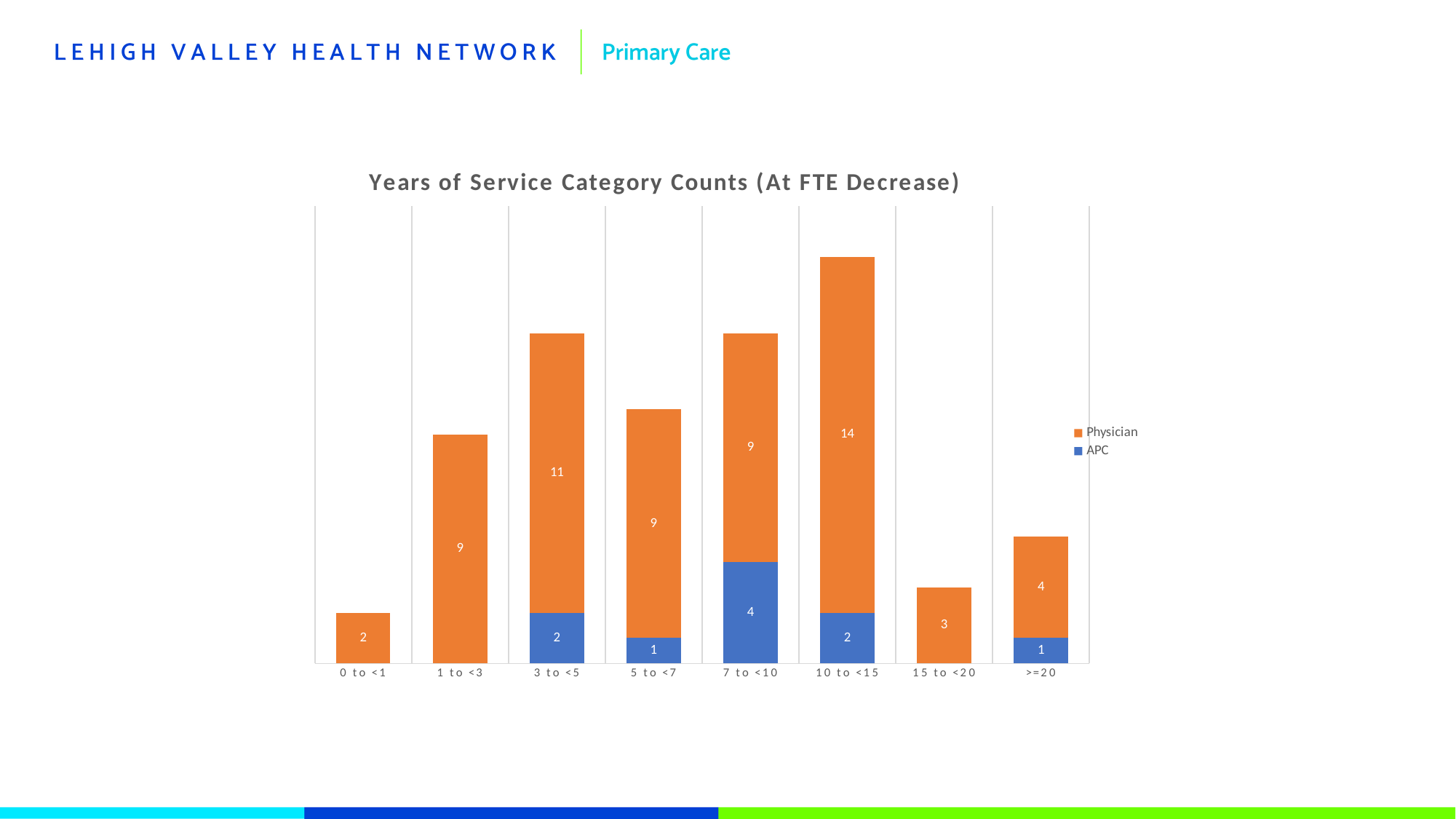
What is the title of the chart? Years of Service Category Counts (At FTE Decrease) Which category has the highest Physician count? 10 to <15 Which is larger, the APC count for 7 to <10 or the APC count for 10 to <15? 7 to <10 What is the difference between the Physician count for 3 to <5 and the Physician count for 5 to <7? 2 How many series does the legend list? 2 What is the APC count for the 7 to <10 category? 4 What type of chart is shown on the slide? Stacked bar chart What is the Physician count for the 10 to <15 category? 14 What is the Physician count for the 15 to <20 category? 3 How many years-of-service categories are shown on the x axis? 8 What is the total count (Physician plus APC) for the 3 to <5 category? 13 Which category has the lowest Physician count? 0 to <1